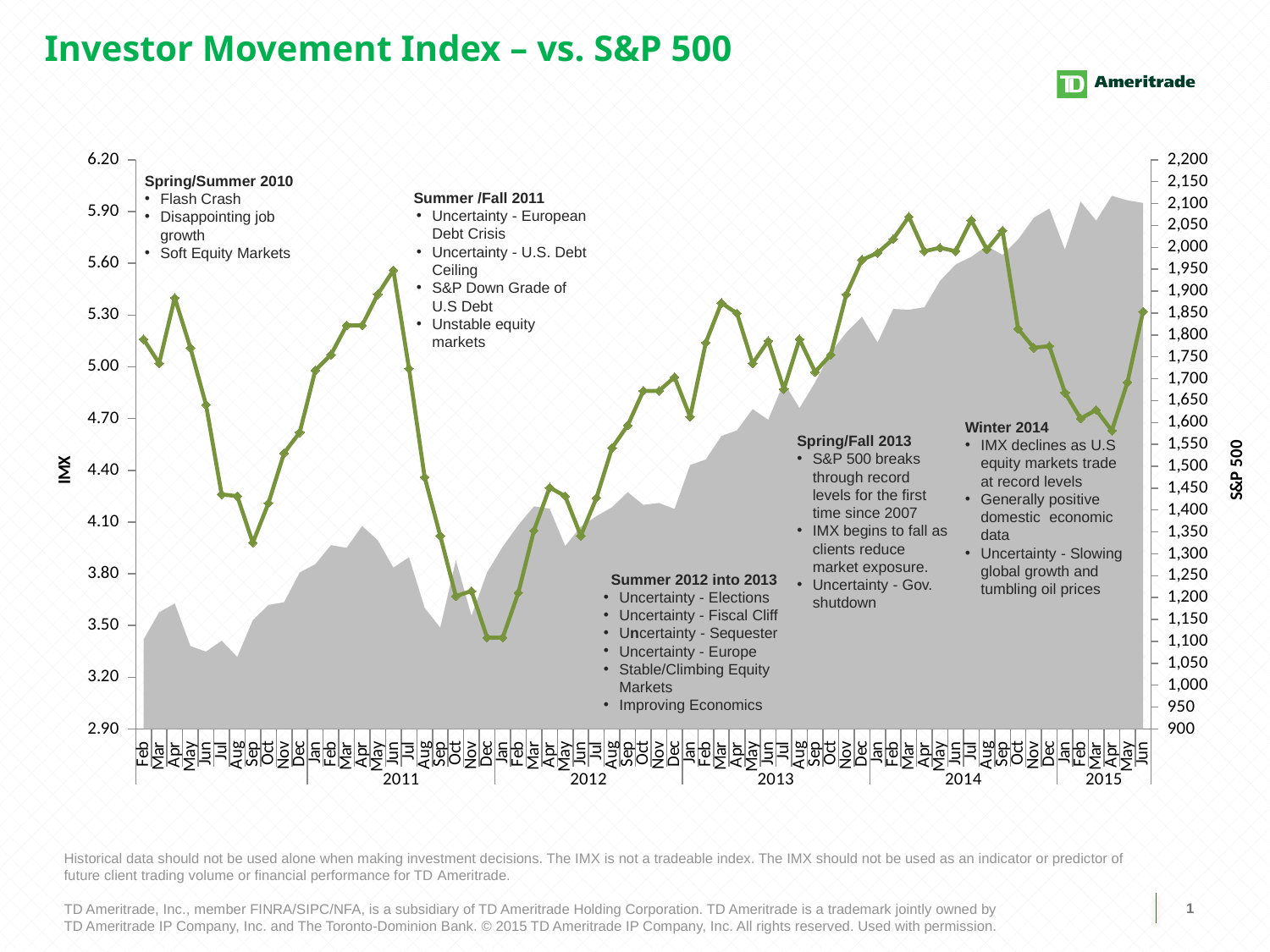
Does the IMX line rise or fall from Mar 2014 to Mar 2015? fall Is the IMX value for Sep 2010 greater or less than 4.40? less What kind of chart is shown on the slide? Line chart with a shaded area What label is shown on the right-hand vertical axis of the chart? S&P 500 Does the S&P 500 shaded area generally rise or fall from 2010 to 2015? rise What is the title of the chart on the slide? Investor Movement Index – vs. S&P 500 Which is larger, the IMX value for Jun 2011 or the IMX value for Jun 2012? Jun 2011 How many year labels (2011 through 2015) appear along the x axis of the chart? 5 Is the IMX value for Dec 2011 greater or less than 3.80? less Is the S&P 500 value for Feb 2010 greater or less than 1,200? less